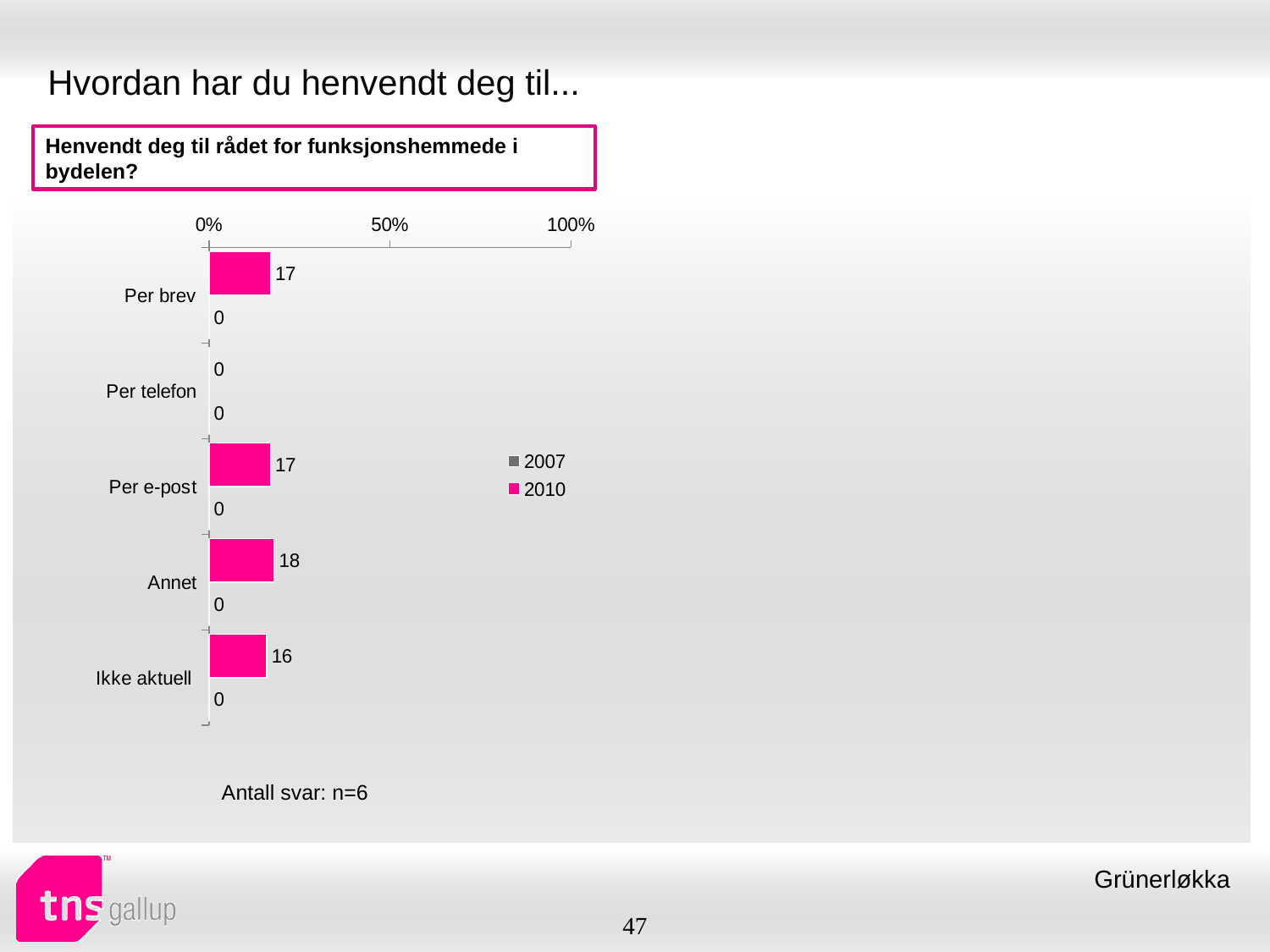
Which category has the highest value in the 2010 series? Annet What is the difference between the 2010 values for Annet and Ikke aktuell? 2 Which is larger in the 2010 series, Per brev or Ikke aktuell? Per brev How many series does the legend list? 2 What is the value for Annet in the 2010 series? 18 What is the value for Ikke aktuell in the 2010 series? 16 What is the value for Per e-post in the 2007 series? 0 What is the value for Per brev in the 2010 series? 17 How many categories are shown on the chart? 5 What is the value for Per telefon in the 2010 series? 0 What kind of chart is shown on the slide? bar chart Is the 2010 value for Annet greater or less than 50%? less